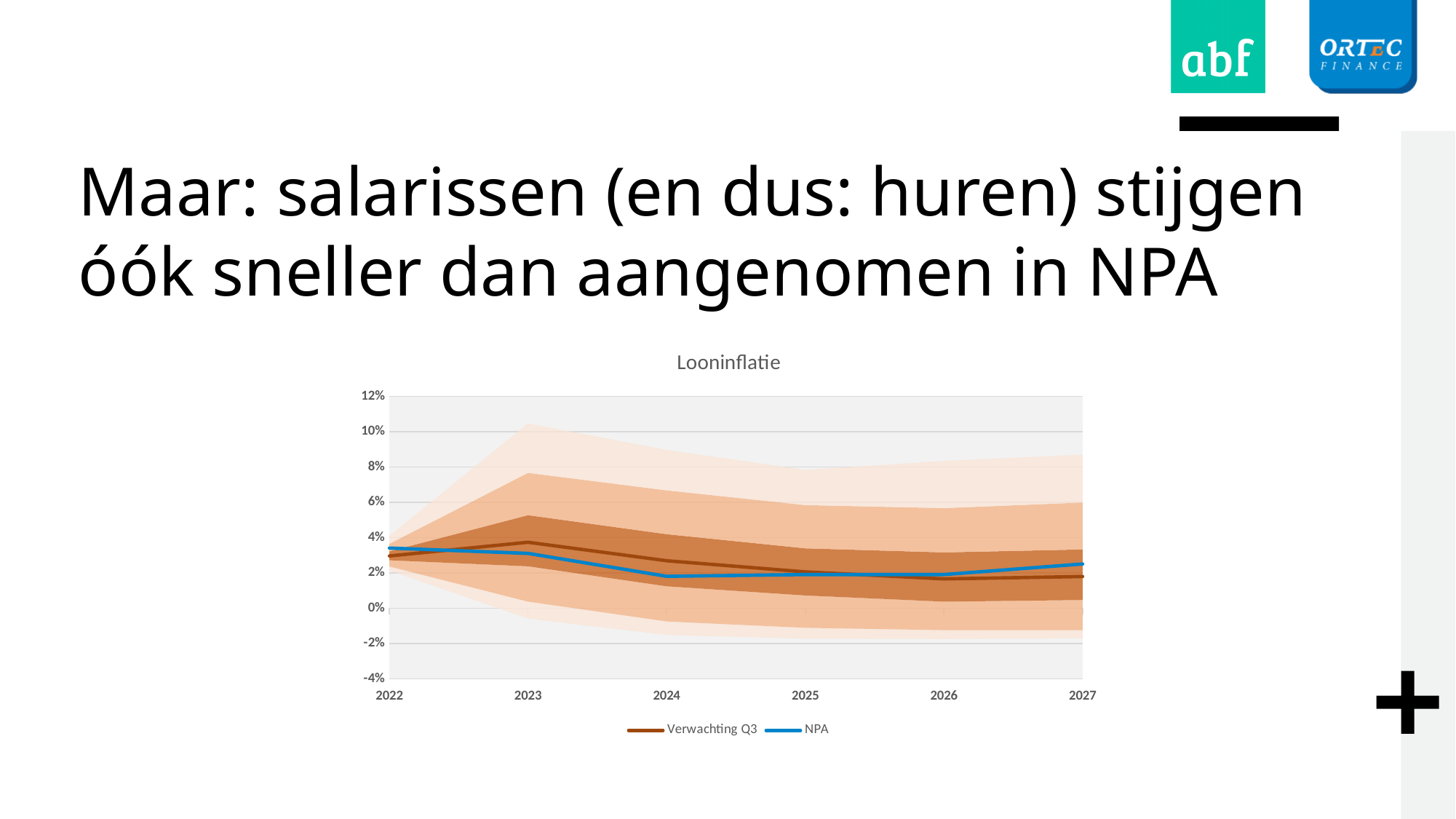
What kind of chart is shown on the slide? Combination area and line chart (lines with shaded bands) How many years are shown on the x axis? 6 What is the title of the chart? Looninflatie Does the Verwachting Q3 line rise or fall from 2023 to 2026? fall In 2024, which series is higher, Verwachting Q3 or NPA? Verwachting Q3 In which year does the Verwachting Q3 line reach its highest value? 2023 Which two series are listed in the legend? Verwachting Q3 and NPA In 2027, which series is higher, Verwachting Q3 or NPA? NPA Is the value for NPA in 2024 greater or less than 4%? less How many series does the legend list? 2 Does the NPA line rise or fall from 2024 to 2027? rise Is the value for Verwachting Q3 in 2023 greater or less than 2%? greater